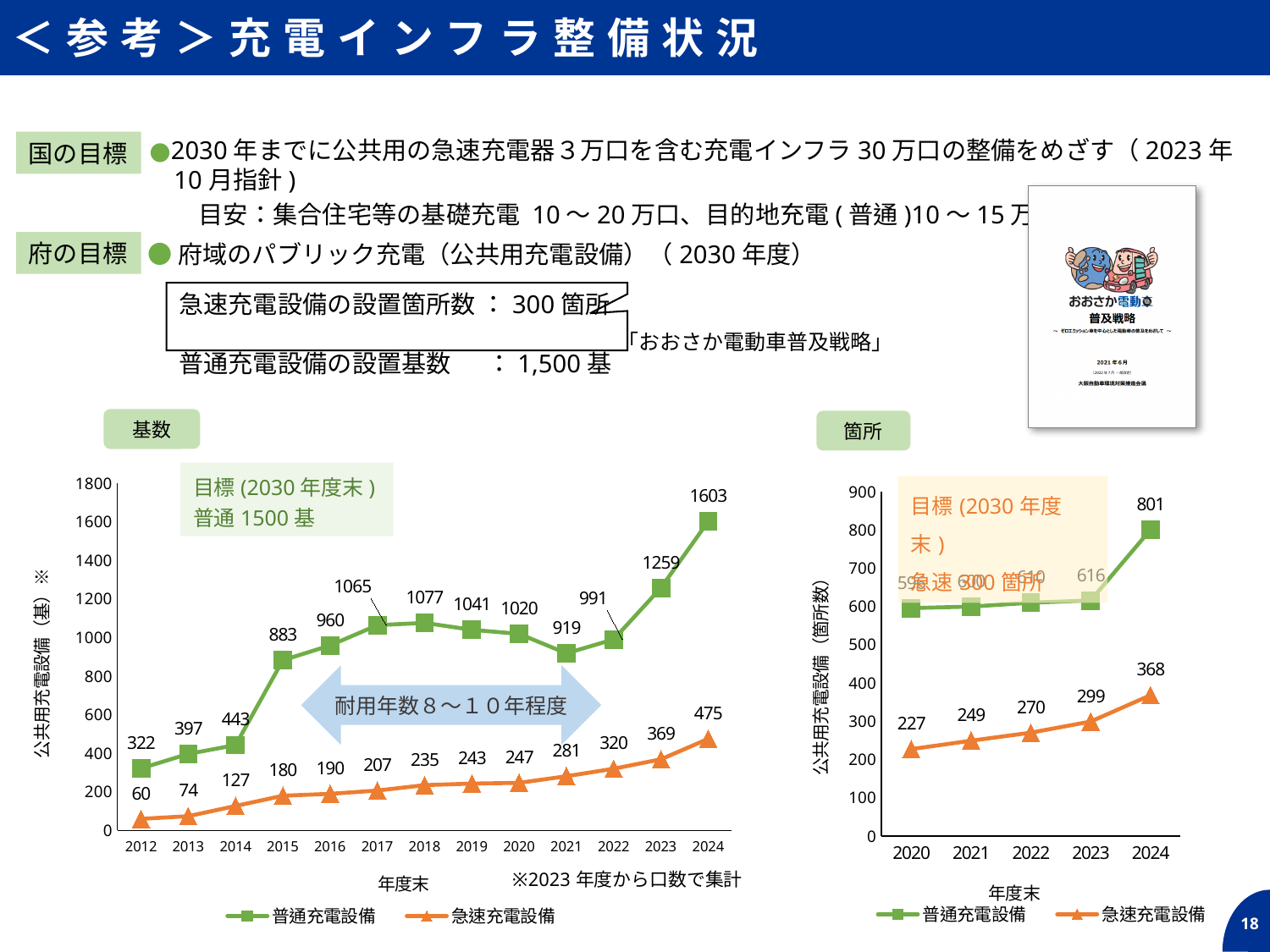
In the left chart (基数), what is the difference between 普通充電設備 and 急速充電設備 in 2024? 1128 In the right chart (箇所), how many series does the legend list? 2 In the left chart (基数), what is the value for 急速充電設備 in 2012? 60 In the left chart (基数), what is the value for 普通充電設備 in 2021? 919 In the left chart (基数), how many years are plotted on the x axis? 13 In the left chart (基数), in which year is 急速充電設備 highest? 2024 In the left chart (基数), what is the value for 普通充電設備 in 2024? 1603 In the right chart (箇所), what is the value for 普通充電設備 in 2024? 801 In the right chart (箇所), what is the value for 急速充電設備 in 2024? 368 In the left chart (基数), in which year is 普通充電設備 lowest? 2012 In the right chart (箇所), does 急速充電設備 rise or fall from 2020 to 2024? rise In the left chart (基数), what kind of chart is it? line chart